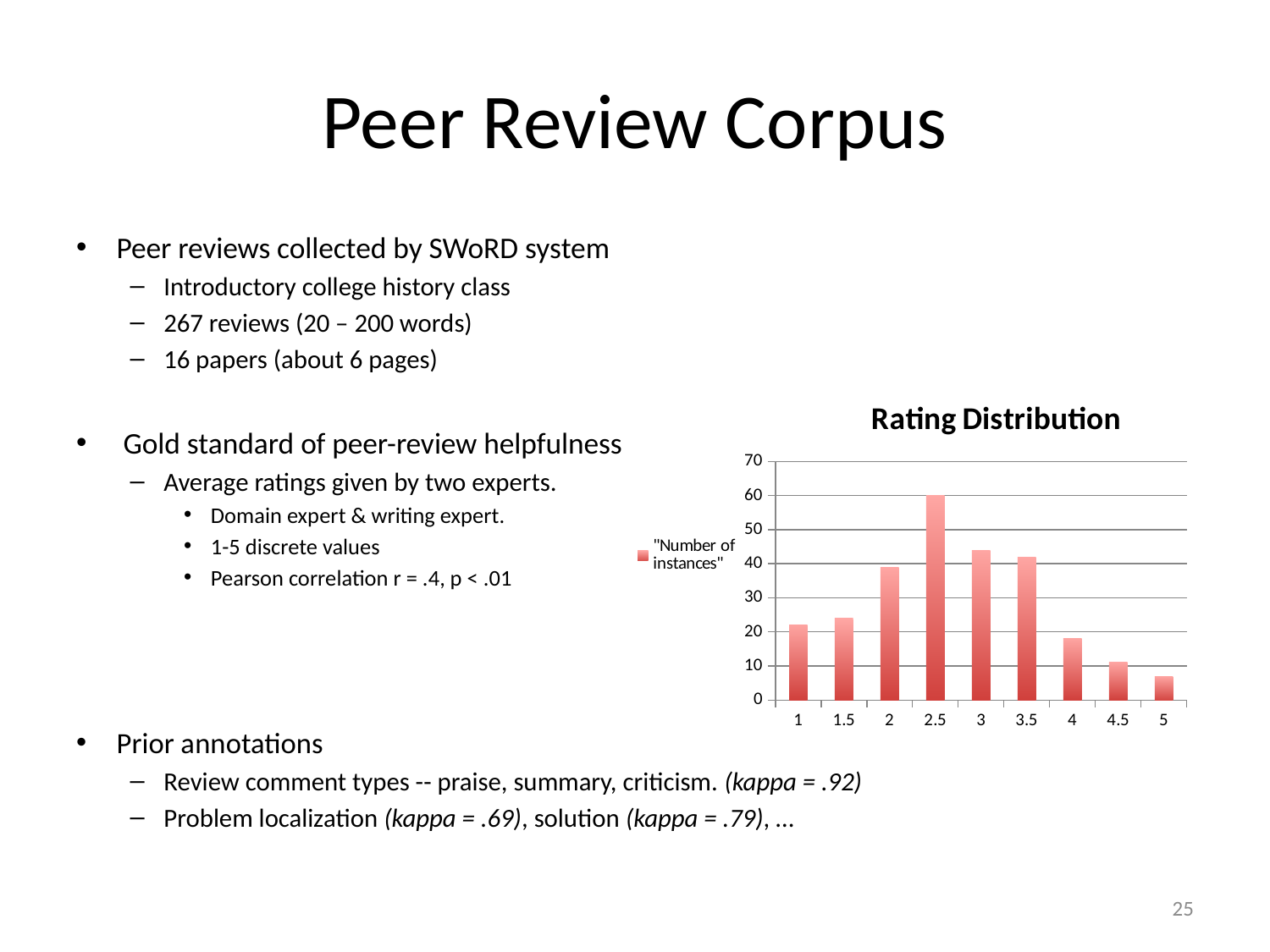
How many rating categories are shown on the x axis of the chart? 9 Is the number of instances for rating 5 greater or less than 10? less What is the legend entry for the series in the chart? "Number of instances" Which rating has the lowest number of instances? 5 Which rating has the highest number of instances? 2.5 What is the title of the chart? Rating Distribution What kind of chart is shown on the slide? bar chart Is the number of instances for rating 2.5 greater or less than 50? greater How many series does the chart legend list? 1 Is the number of instances for rating 4 greater or less than 20? less Which rating has more instances, 4 or 5? 4 Which rating has more instances, 2.5 or 3? 2.5